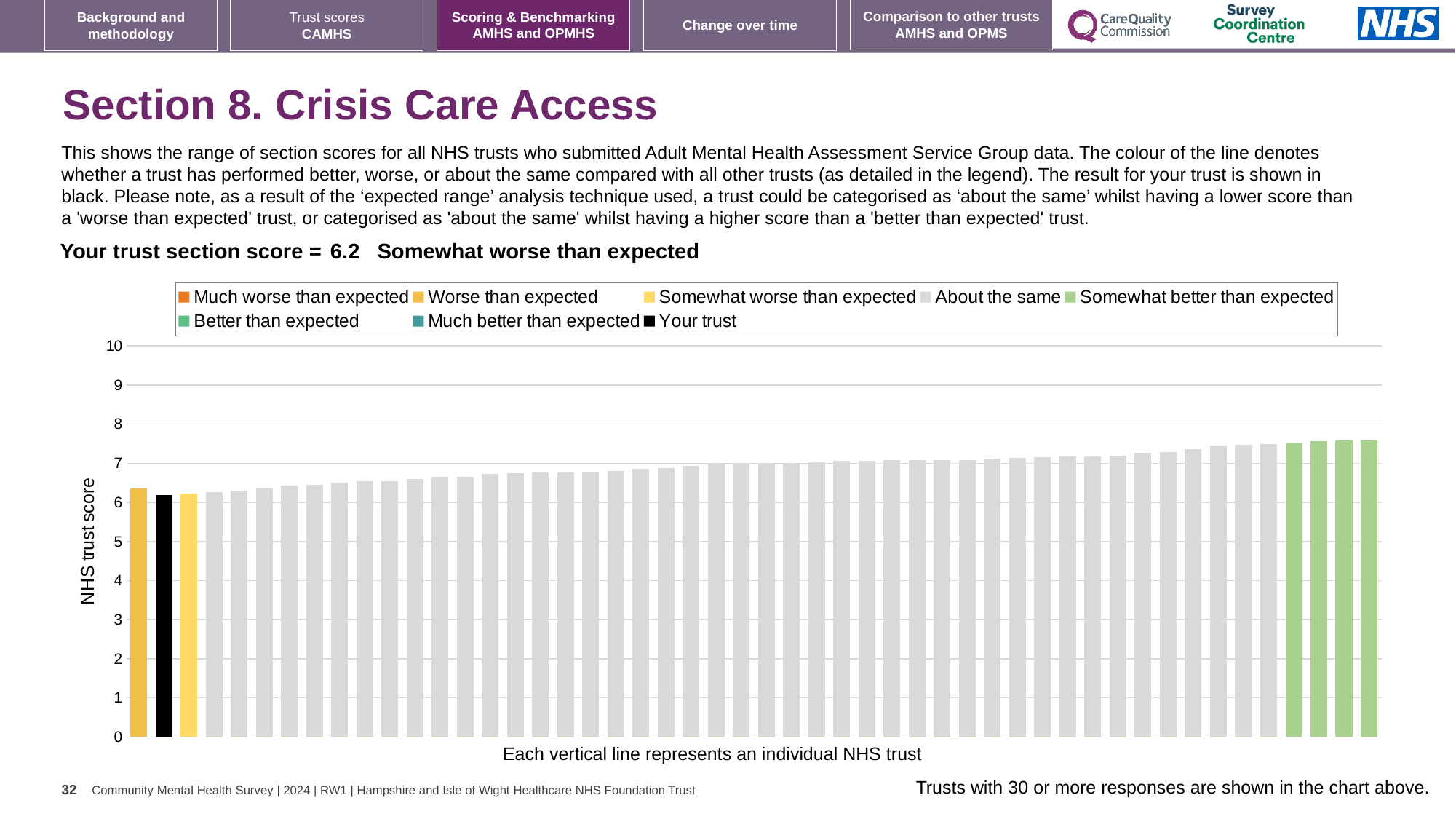
Is the value of the tallest bar in the chart greater or less than 8? less What colour is the bar representing your trust? black Is the value of the tallest bar in the chart greater or less than 7? greater Is the value of the black 'Your trust' bar greater or less than 7? less How many entries does the chart legend list? 8 Which category is your trust's section score placed in? Somewhat worse than expected Do the bar values rise or fall from left to right across the chart? rise What is the label on the vertical axis of the chart? NHS trust score How many bars in the chart are coloured green (somewhat better than expected)? 4 What is the section score for your trust shown on the slide? 6.2 What kind of chart is shown on the slide? bar chart